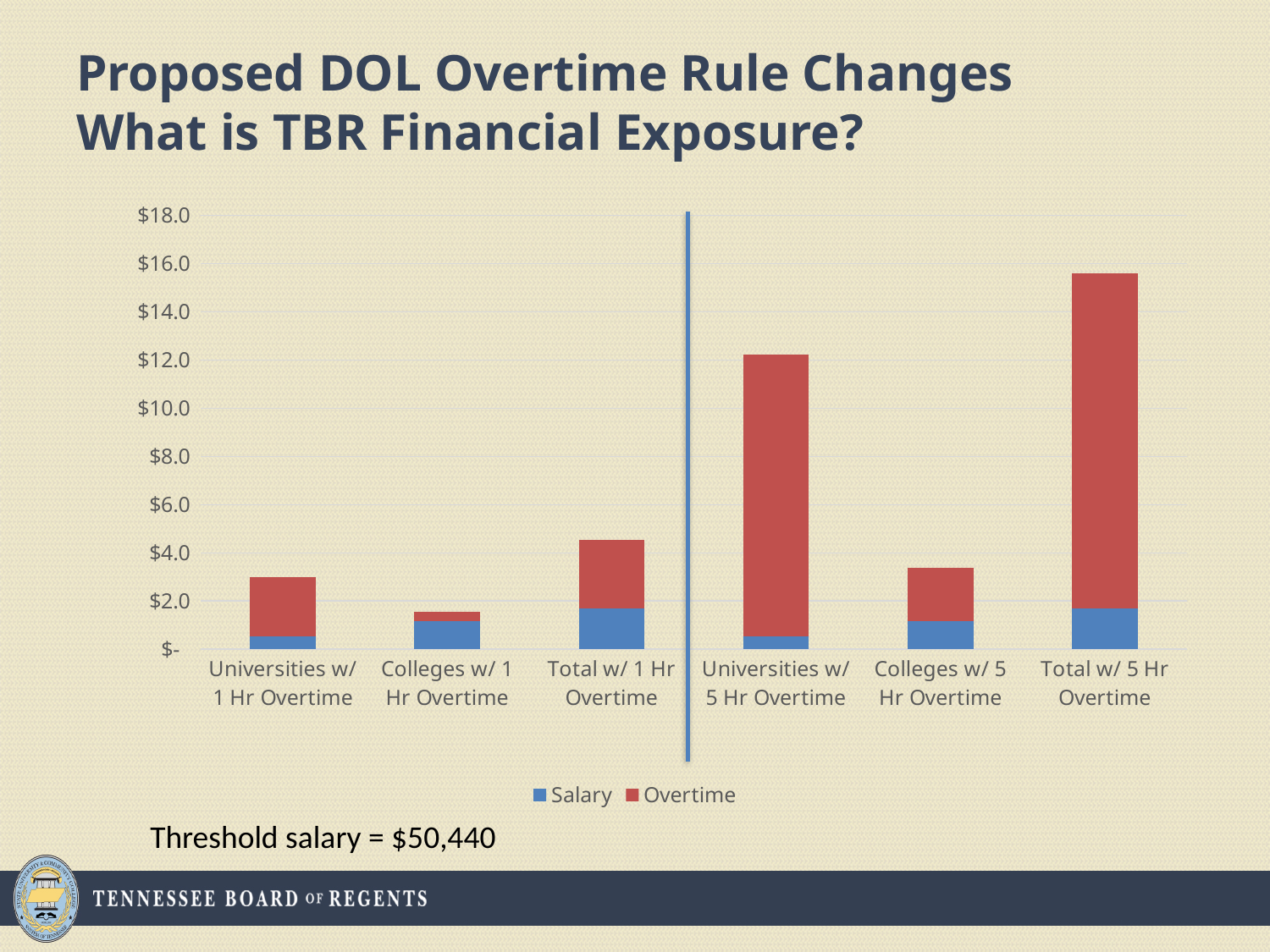
Is the total bar for Colleges w/ 1 Hr Overtime greater or less than $2.0? less What are the two series named in the chart's legend? Salary and Overtime Which has the larger stacked bar, Universities w/ 5 Hr Overtime or Colleges w/ 5 Hr Overtime? Universities w/ 5 Hr Overtime Which category has the tallest stacked bar? Total w/ 5 Hr Overtime What kind of chart is shown on the slide? Stacked bar chart How many categories are shown along the x axis of the chart? 6 Is the total bar for Total w/ 5 Hr Overtime greater or less than $14.0? greater How many series does the chart's legend list? 2 Is the total bar for Colleges w/ 5 Hr Overtime greater or less than $4.0? less Which category has the shortest stacked bar? Colleges w/ 1 Hr Overtime Which colour represents the Overtime series in the chart? Red